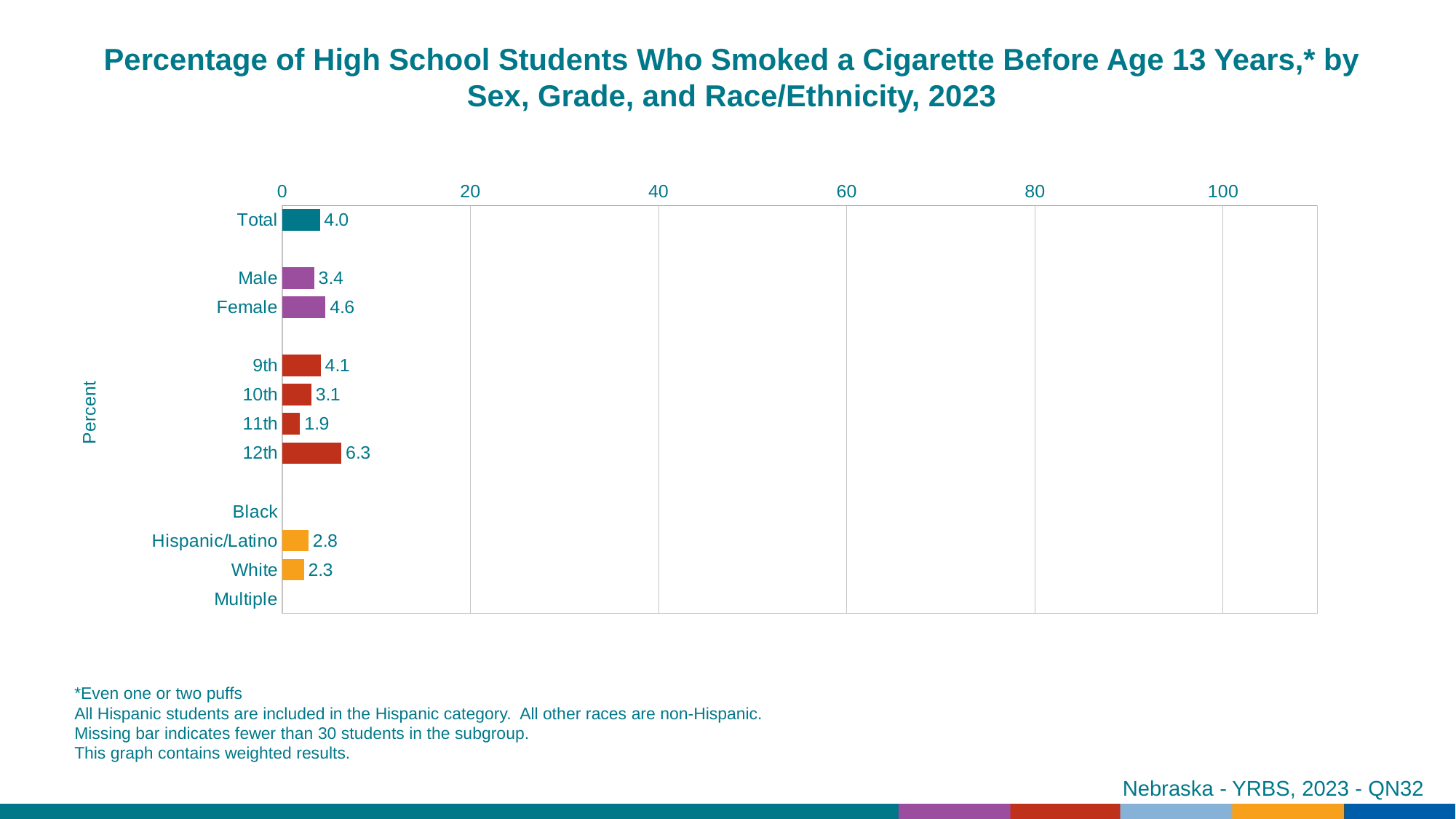
What is the value for Hispanic/Latino? 2.8 Which category has the highest value? 12th What kind of chart is shown? bar chart How many categories are labeled on the vertical axis? 12 Among the categories with a bar shown, which has the lowest value? 11th What is the difference between the Female and Male values? 1.2 What is the value for 12th grade? 6.3 What is the label on the vertical axis? Percent What is the value for Total? 4.0 Which is larger, the value for 9th grade or 10th grade? 9th Is the value for 12th grade greater or less than 20? less Which categories have no bar shown? Black and Multiple